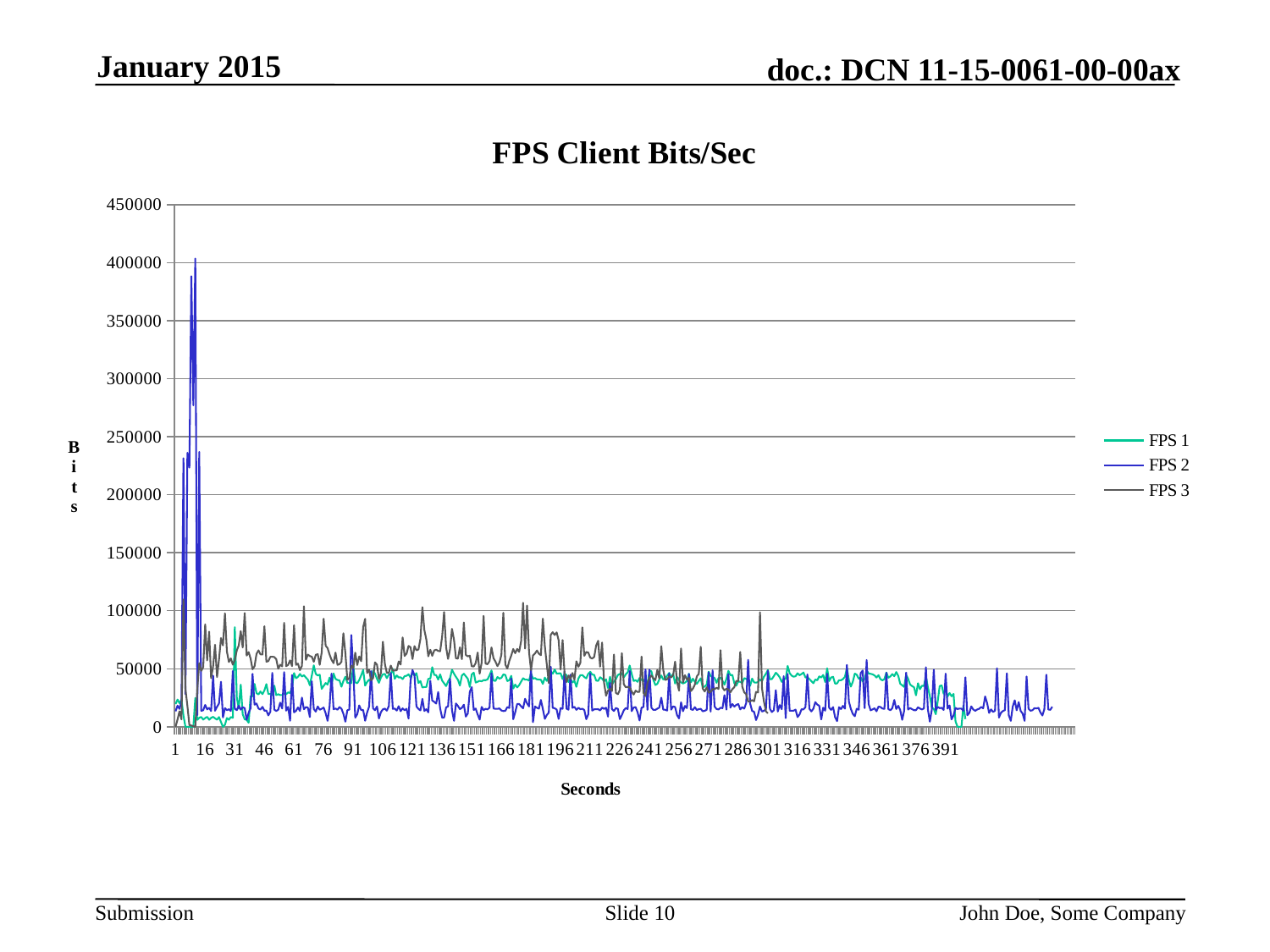
Which series reaches the highest value on the chart? FPS 2 Do the values of FPS 3 generally rise or fall along the x axis after the first few seconds? fall Is the highest value reached by FPS 3 greater or less than 150000? less Is the value of FPS 2 at second 1 greater or less than 50000? less Between seconds 46 and 196, which series is generally higher, FPS 2 or FPS 3? FPS 3 Is the highest value reached by FPS 1 greater or less than 150000? less What is the title of the chart? FPS Client Bits/Sec How many series does the legend list? 3 What colour is the FPS 2 line in the chart? blue What kind of chart is shown on the slide? line chart